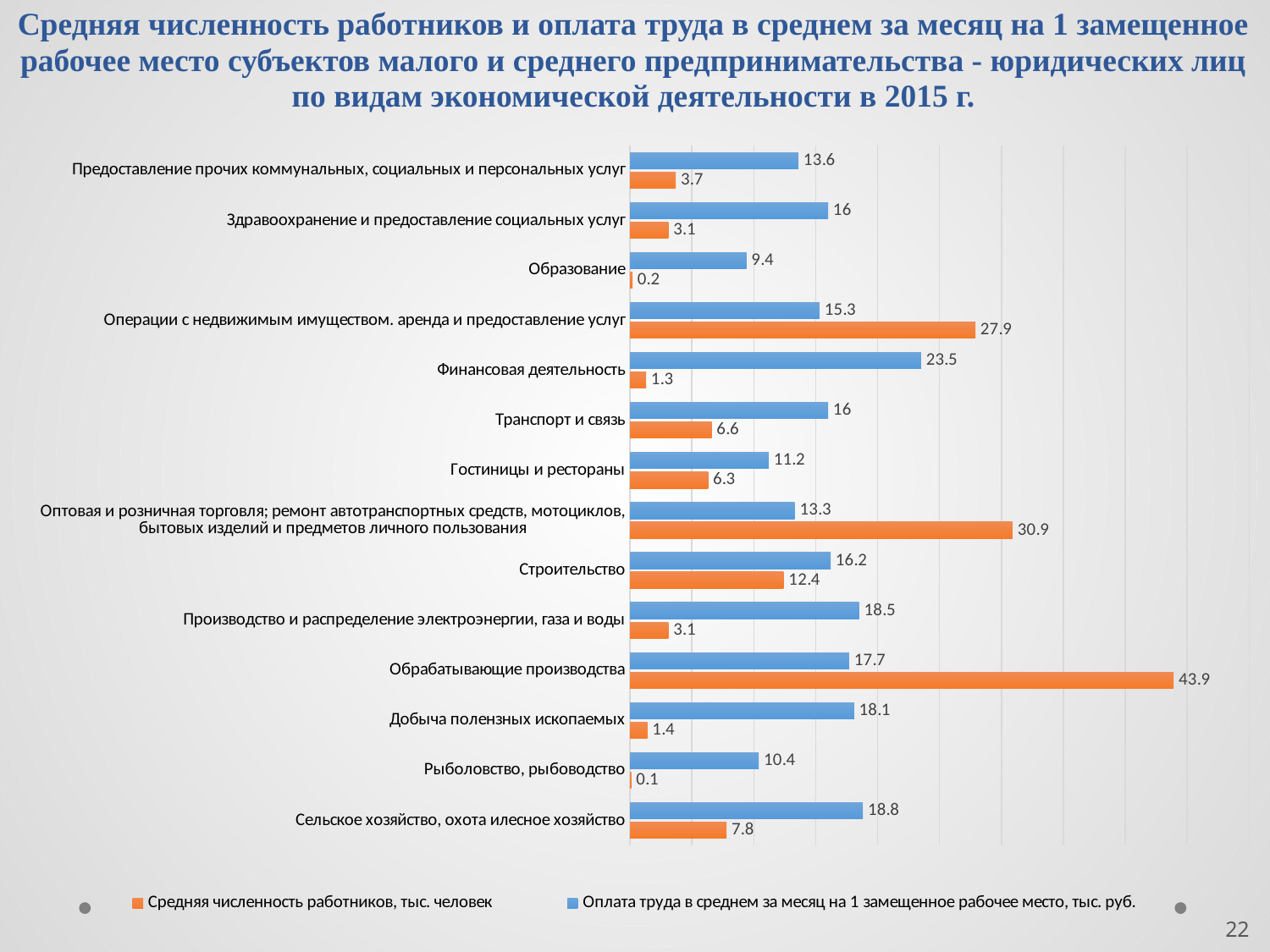
What type of chart is shown on the slide? Bar chart Which is larger for 'Строительство': 'Средняя численность работников, тыс. человек' or 'Оплата труда в среднем за месяц на 1 замещенное рабочее место, тыс. руб.'? Оплата труда в среднем за месяц на 1 замещенное рабочее место, тыс. руб. Which category has the lowest value for 'Оплата труда в среднем за месяц на 1 замещенное рабочее место, тыс. руб.'? Образование What is the value of 'Оплата труда в среднем за месяц на 1 замещенное рабочее место, тыс. руб.' for 'Финансовая деятельность'? 23.5 Which category has the lowest value for 'Средняя численность работников, тыс. человек'? Рыболовство, рыбоводство What is the value of 'Средняя численность работников, тыс. человек' for 'Образование'? 0.2 How many types of economic activity (categories) are shown on the chart? 14 What is the difference between the 'Средняя численность работников, тыс. человек' values for 'Оптовая и розничная торговля; ремонт автотранспортных средств, мотоциклов, бытовых изделий и предметов личного пользования' and 'Операции с недвижимым имуществом. аренда и предоставление услуг'? 3 Which category has the highest value for 'Средняя численность работников, тыс. человек'? Обрабатывающие производства What is the value of 'Средняя численность работников, тыс. человек' for 'Обрабатывающие производства'? 43.9 Which colour represents 'Средняя численность работников, тыс. человек' in the chart? Orange How many series does the legend list? 2